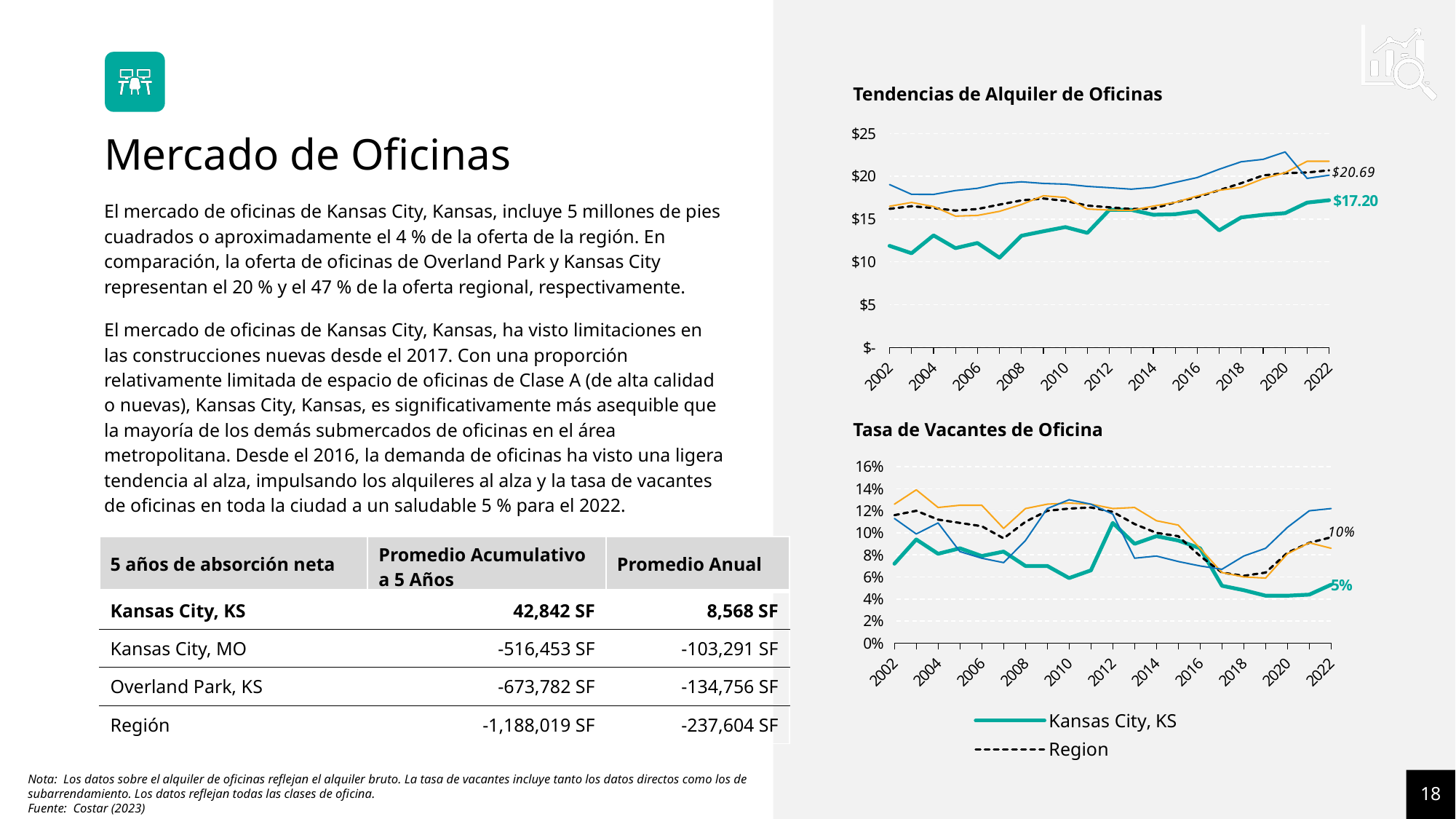
In the 'Tendencias de Alquiler de Oficinas' chart, does the Kansas City, KS line generally rise or fall from 2002 to 2022? rise In the 'Tasa de Vacantes de Oficina' chart, what is the labeled 2022 value for Kansas City, KS? 5% What is the title of the top chart on the slide? Tendencias de Alquiler de Oficinas What kind of chart is the 'Tendencias de Alquiler de Oficinas' chart? line chart In the 'Tendencias de Alquiler de Oficinas' chart, what is the labeled 2022 value for Kansas City, KS? $17.20 In the 'Tasa de Vacantes de Oficina' chart, what is the labeled 2022 value for the Region? 10% In the 'Tendencias de Alquiler de Oficinas' chart, which is higher in 2022: Kansas City, KS or the Region? Region In the 'Tendencias de Alquiler de Oficinas' chart, what is the labeled 2022 value for the Region? $20.69 How many series does the legend of the 'Tasa de Vacantes de Oficina' chart list? 2 In the 'Tendencias de Alquiler de Oficinas' chart, is the Kansas City, KS value in 2002 greater or less than $15? less In the 'Tasa de Vacantes de Oficina' chart, is the Kansas City, KS value in 2012 greater or less than 8%? greater In the 'Tendencias de Alquiler de Oficinas' chart, what is the difference between the 2022 Region value and the 2022 Kansas City, KS value? $3.49